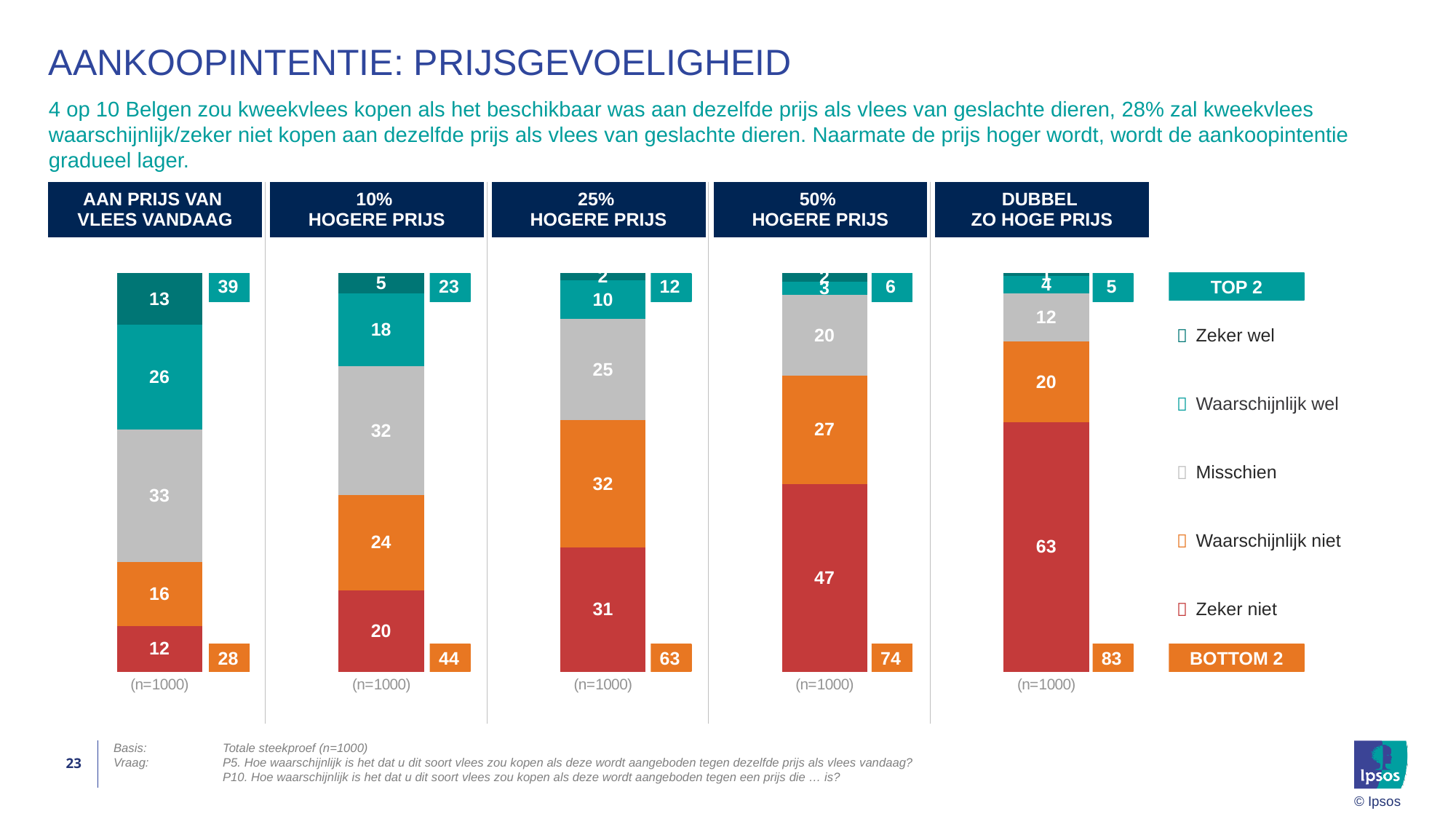
In the '10% HOGERE PRIJS' chart, which category has the lowest value? Zeker wel In the '25% HOGERE PRIJS' chart, which is larger: 'Waarschijnlijk niet' or 'Misschien'? Waarschijnlijk niet In the 'AAN PRIJS VAN VLEES VANDAAG' chart, what is the difference between 'Waarschijnlijk wel' and 'Zeker wel'? 13 In the 'AAN PRIJS VAN VLEES VANDAAG' chart, what is the value for 'Misschien'? 33 In the 'DUBBEL ZO HOGE PRIJS' chart, what is the value for 'Waarschijnlijk niet'? 20 In the '10% HOGERE PRIJS' chart, what is the value for 'Waarschijnlijk niet'? 24 In the '25% HOGERE PRIJS' chart, what is the value for 'Zeker niet'? 31 How many series does the legend list? 5 What kind of chart is used on this slide? Stacked bar chart In the '50% HOGERE PRIJS' chart, what is the value for 'Zeker niet'? 47 In the 'DUBBEL ZO HOGE PRIJS' chart, which category has the highest value? Zeker niet In the 'AAN PRIJS VAN VLEES VANDAAG' chart, which category has the highest value? Misschien